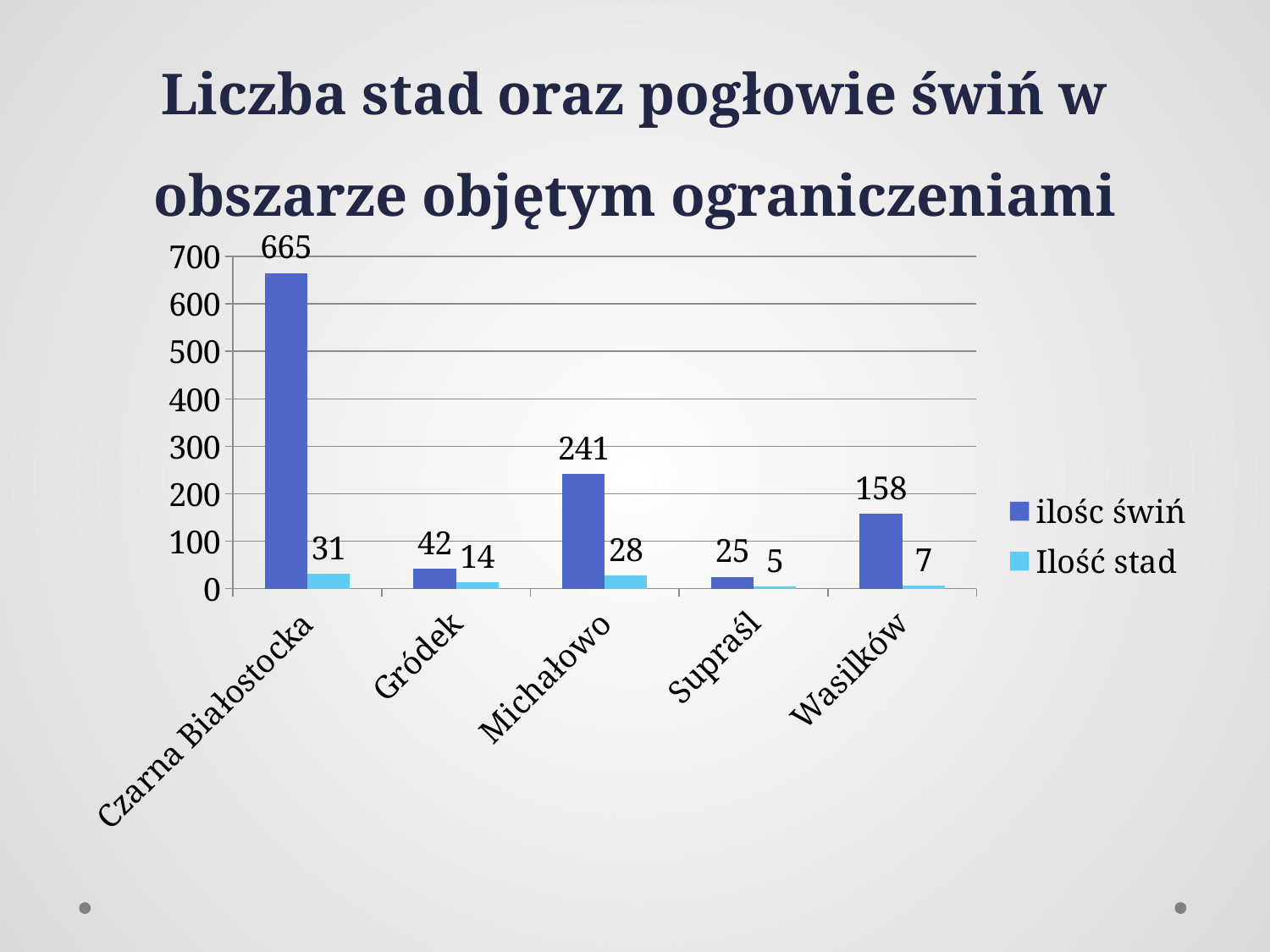
What is the value of 'ilośc świń' for Wasilków? 158 What is the value of 'ilośc świń' for Czarna Białostocka? 665 What is the value of 'Ilość stad' for Michałowo? 28 How many categories are shown on the x axis? 5 Which category has the lowest value for 'Ilość stad'? Supraśl What is the title of the chart? Liczba stad oraz pogłowie świń w obszarze objętym ograniczeniami How many series does the legend list? 2 Which category has the highest value for 'ilośc świń'? Czarna Białostocka Is the value of 'ilośc świń' for Michałowo greater or less than 200? greater What is the difference between 'ilośc świń' for Michałowo and Wasilków? 83 What kind of chart is shown on the slide? bar chart Which is larger: 'Ilość stad' for Gródek or 'Ilość stad' for Wasilków? Gródek